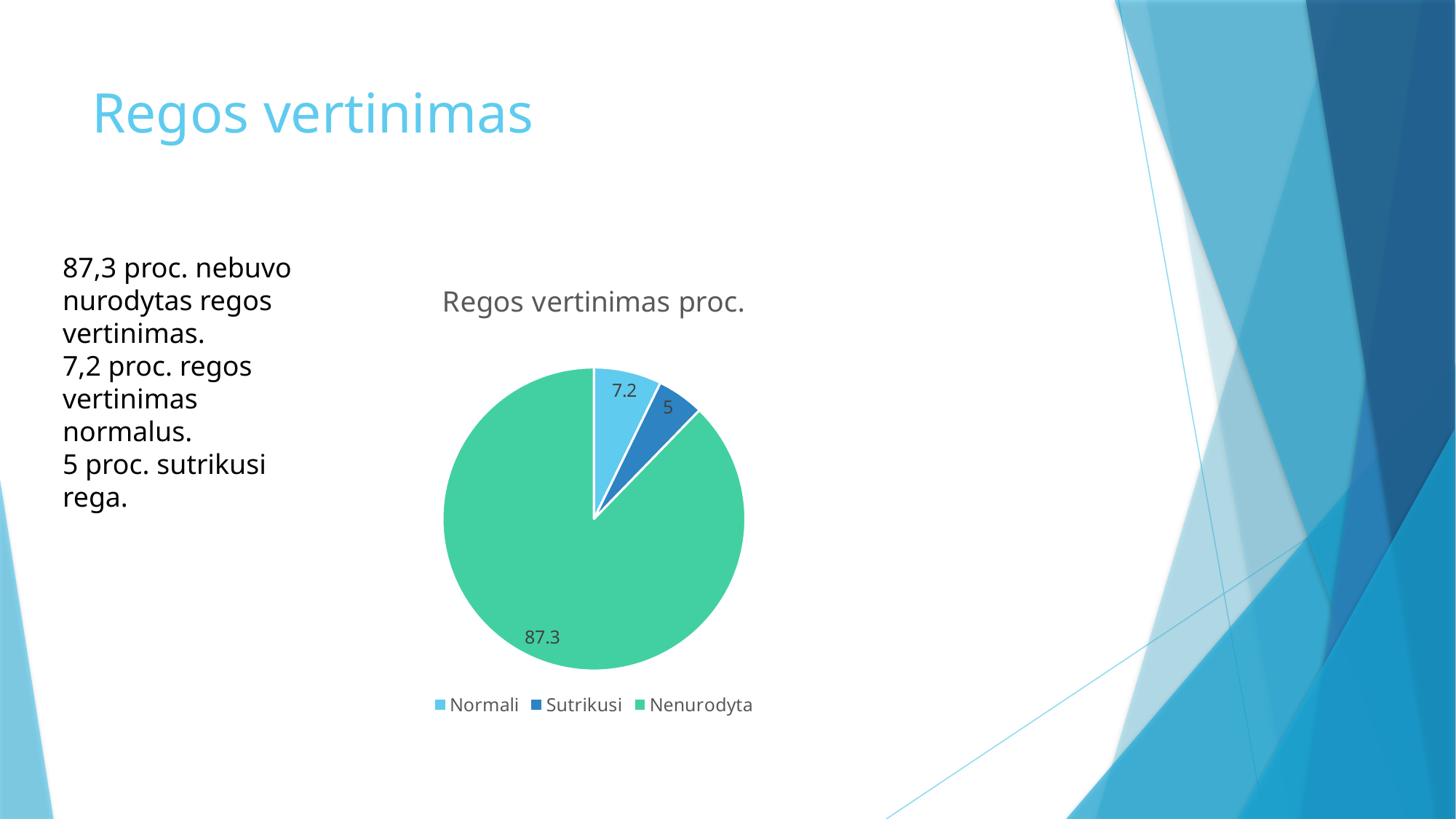
How many categories does the pie chart have? 3 What is the value for Normali? 7.2 Which is larger, the value for Normali or the value for Sutrikusi? Normali What is the difference between the values for Nenurodyta and Normali? 80.1 What kind of chart is shown on the slide? pie chart What is the difference between the values for Normali and Sutrikusi? 2.2 What is the title of the chart? Regos vertinimas proc. What is the value for Nenurodyta? 87.3 Which colour represents Nenurodyta in the legend? green Which category has the smallest slice? Sutrikusi Which category has the largest slice? Nenurodyta What is the value for Sutrikusi? 5